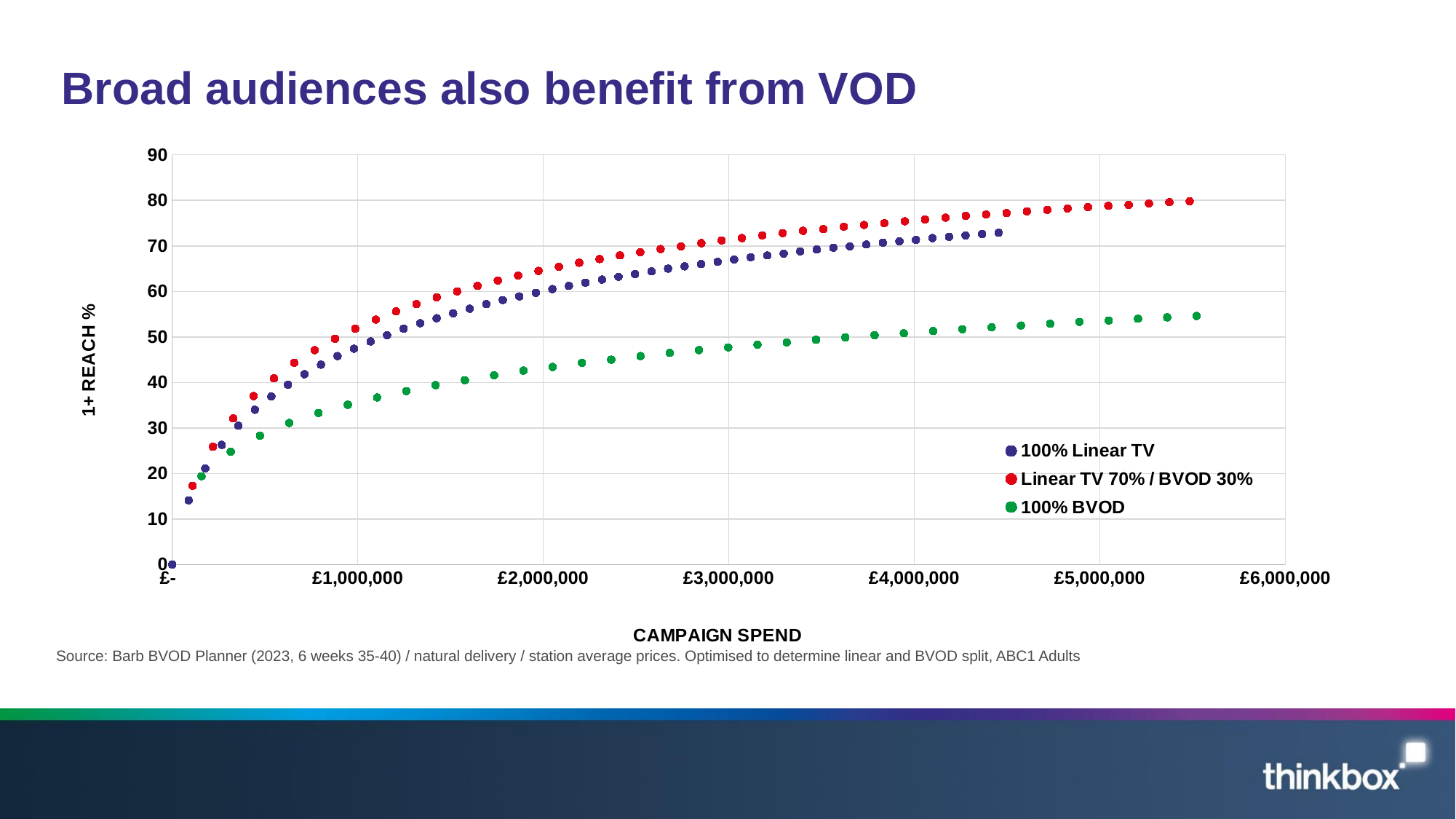
At a campaign spend of £5,000,000, is the 1+ reach % for Linear TV 70% / BVOD 30% greater or less than 70? greater At a campaign spend of £3,000,000, is the 1+ reach % for 100% BVOD greater or less than 50? less How many series does the legend list? 3 What is the title of the slide? Broad audiences also benefit from VOD At a campaign spend of £3,000,000, which series has the higher 1+ reach %: 100% Linear TV or 100% BVOD? 100% Linear TV At a campaign spend of £2,000,000, is the 1+ reach % for Linear TV 70% / BVOD 30% greater or less than 60? greater Which series has the lowest 1+ reach % at high campaign spend levels? 100% BVOD What kind of chart is shown on the slide? Scatter chart What is the label of the y axis? 1+ REACH % Which series reaches the highest 1+ reach % on the chart? Linear TV 70% / BVOD 30% Does 1+ reach % rise or fall as campaign spend increases along the x axis? Rise